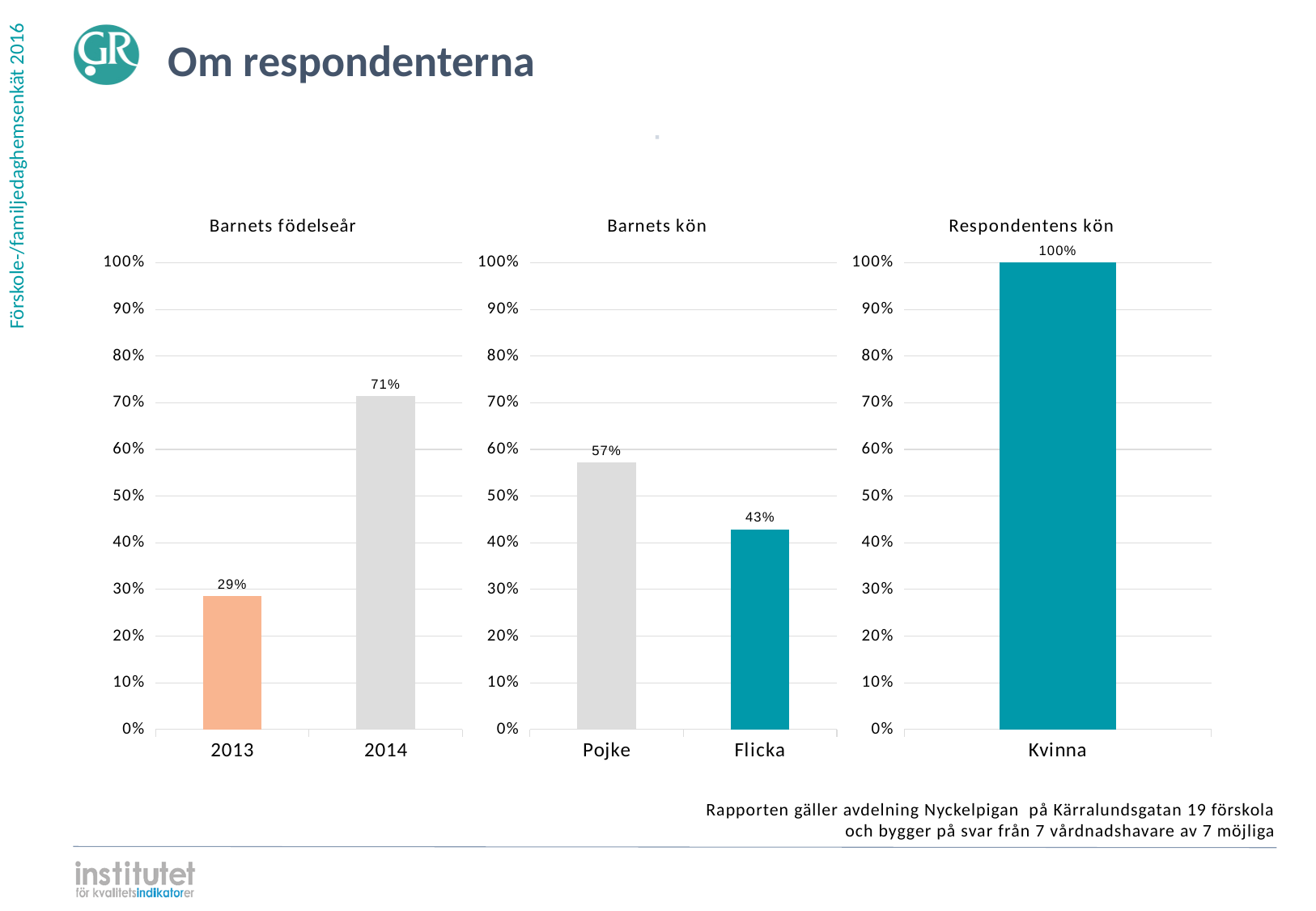
In the 'Respondentens kön' chart, what is the value for Kvinna? 100% In the 'Barnets kön' chart, what is the value for Flicka? 43% In the 'Barnets födelseår' chart, what is the value for 2013? 29% In the 'Barnets födelseår' chart, which category has the highest value? 2014 How many categories are shown in the 'Respondentens kön' chart? 1 In the 'Barnets födelseår' chart, what is the difference between the values for 2014 and 2013? 42% In the 'Barnets kön' chart, which is larger, Pojke or Flicka? Pojke In the 'Barnets kön' chart, what is the difference between Pojke and Flicka? 14% What kind of chart is the 'Barnets kön' chart? Bar chart In the 'Barnets födelseår' chart, what is the value for 2014? 71% How many categories are shown in the 'Barnets födelseår' chart? 2 In the 'Barnets kön' chart, what is the value for Pojke? 57%